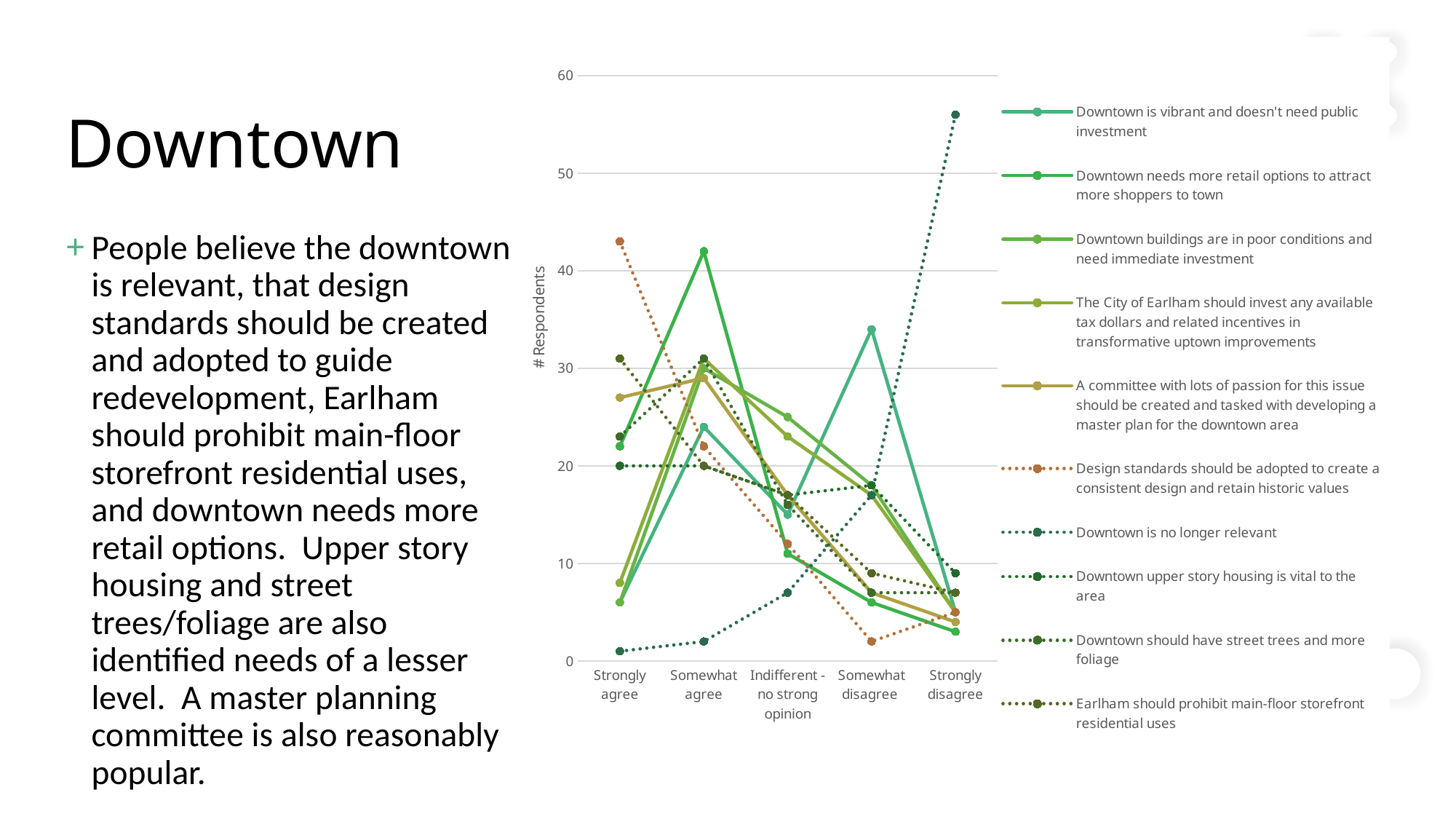
Is the value for 'Downtown needs more retail options to attract more shoppers to town' at Somewhat agree greater or less than 40? greater Is the value for 'Downtown is no longer relevant' at Strongly disagree greater or less than 50? greater What is the label of the y axis? # Respondents What kind of chart is shown on the slide? line chart For which response category does 'Downtown is vibrant and doesn't need public investment' reach its highest value? Somewhat disagree Does the series 'Downtown is no longer relevant' generally rise or fall from Strongly agree to Strongly disagree? rise How many response categories are shown on the x axis? 5 Is the value for 'Downtown is no longer relevant' at Strongly agree greater or less than 10? less At Strongly disagree, which series is larger: 'Downtown is no longer relevant' or 'Downtown is vibrant and doesn't need public investment'? Downtown is no longer relevant For which response category does 'Downtown is no longer relevant' reach its highest value? Strongly disagree How many series does the legend list? 10